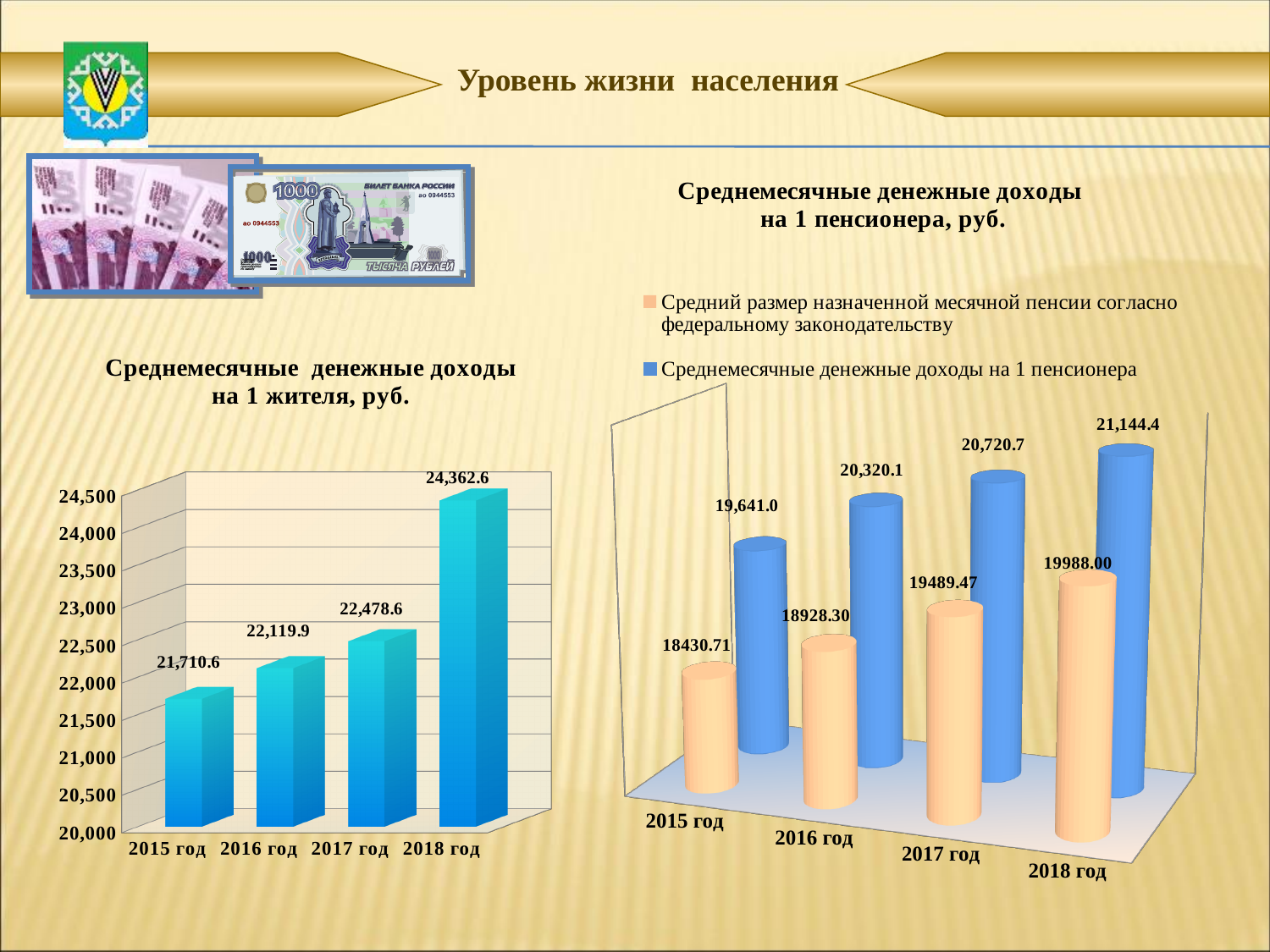
In the chart 'Среднемесячные денежные доходы на 1 жителя, руб.', do the values rise or fall from 2015 год to 2018 год? rise In the chart 'Среднемесячные денежные доходы на 1 жителя, руб.', what is the difference between the 2018 год and 2015 год values? 2,652.0 What kind of chart is 'Среднемесячные денежные доходы на 1 жителя, руб.'? bar chart In the chart 'Среднемесячные денежные доходы на 1 жителя, руб.', how many years are shown? 4 In the chart 'Среднемесячные денежные доходы на 1 пенсионера, руб.', what is the difference between the income per pensioner and the pension for 2018 год? 1,156.4 In the chart 'Среднемесячные денежные доходы на 1 пенсионера, руб.', what is the value of 'Среднемесячные денежные доходы на 1 пенсионера' for 2017 год? 20,720.7 In the chart 'Среднемесячные денежные доходы на 1 пенсионера, руб.', how many series does the legend list? 2 In the chart 'Среднемесячные денежные доходы на 1 жителя, руб.', which year has the lowest value? 2015 год In the chart 'Среднемесячные денежные доходы на 1 пенсионера, руб.', which is larger for 2018 год: the pension ('Средний размер назначенной месячной пенсии') or the income per pensioner ('Среднемесячные денежные доходы на 1 пенсионера')? Среднемесячные денежные доходы на 1 пенсионера In the chart 'Среднемесячные денежные доходы на 1 жителя, руб.', what is the value for 2018 год? 24,362.6 In the chart 'Среднемесячные денежные доходы на 1 пенсионера, руб.', what is the value of 'Средний размер назначенной месячной пенсии согласно федеральному законодательству' for 2016 год? 18928.30 In the chart 'Среднемесячные денежные доходы на 1 жителя, руб.', what is the value for 2015 год? 21,710.6